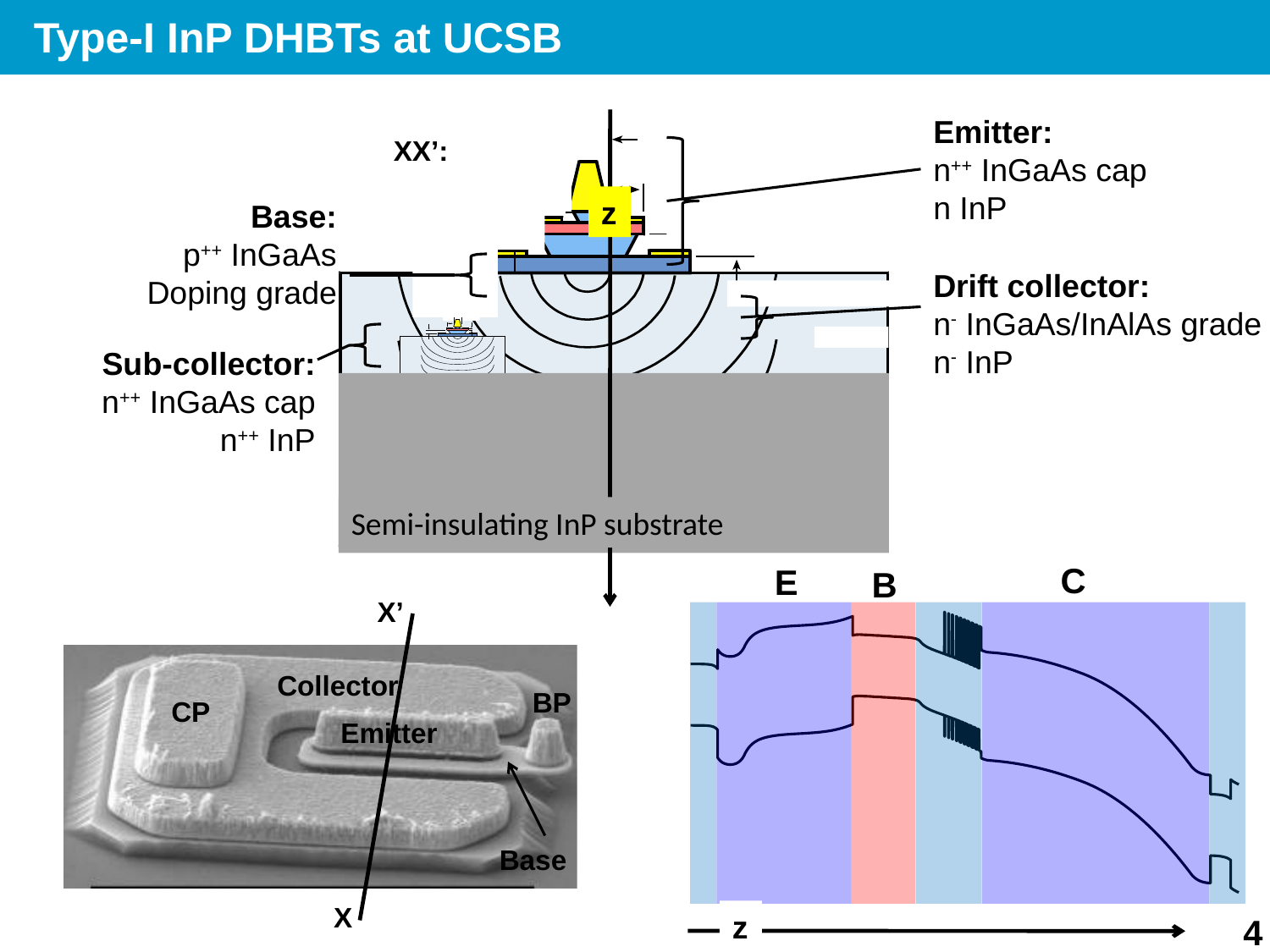
In the band diagram at the bottom right, how many labeled regions (E, B, C) are marked above the plot? 3 In the band diagram at the bottom right, which labeled region is the narrowest along z? B In the band diagram at the bottom right, what is the label on the horizontal axis? z In the band diagram at the bottom right, how many band curves are plotted? 2 In the band diagram at the bottom right, do the two band curves rise or fall along z within the C region? fall In the band diagram at the bottom right, which region label is shaded pink/red? B In the band diagram at the bottom right, which region comes first along the z axis: E or C? E In the band diagram at the bottom right, which labeled region is the widest along z? C